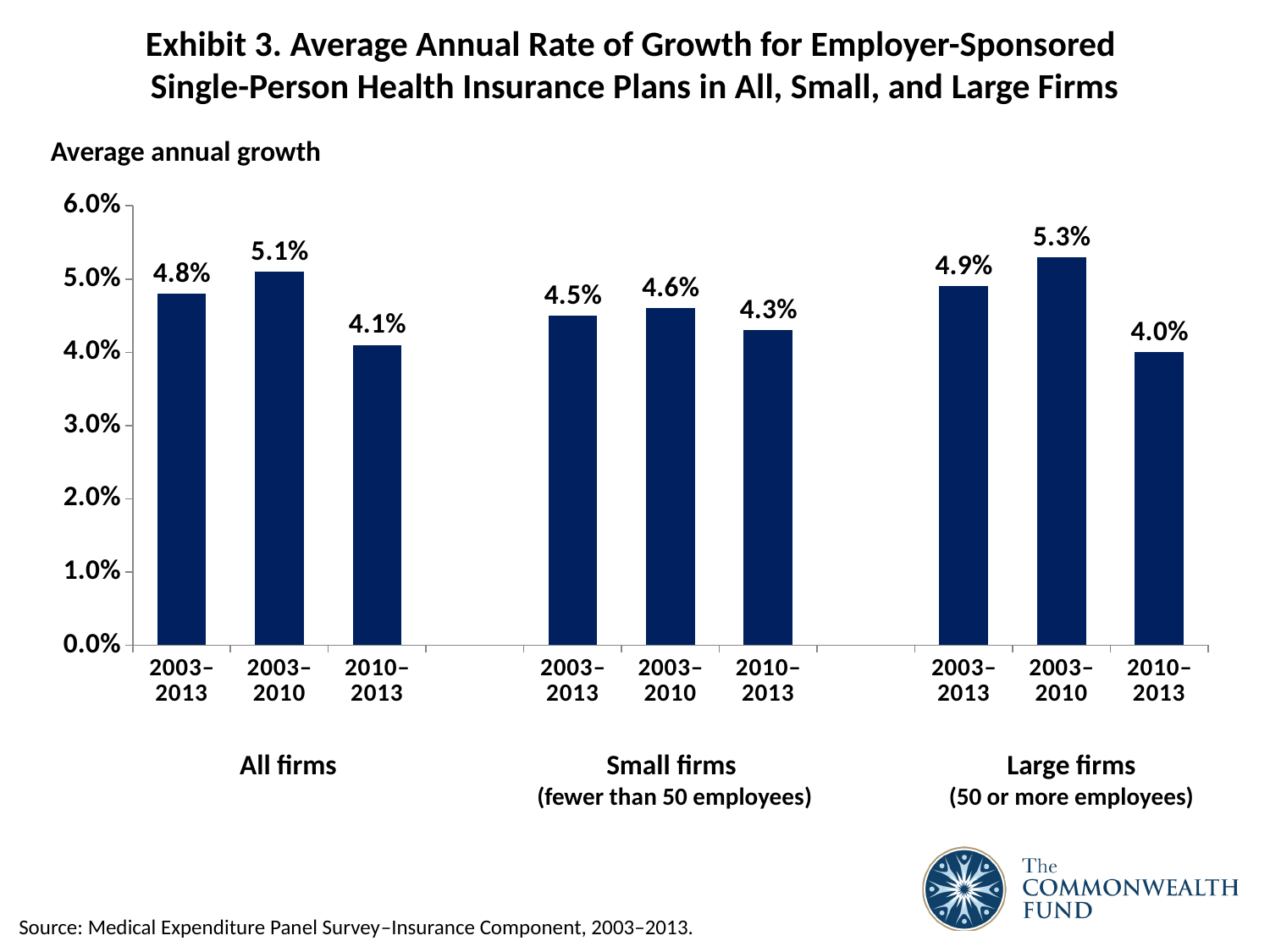
Which is larger: the 2003–2013 growth rate for small firms or for large firms? Large firms How many bars are plotted on the chart? 9 What is the label of the vertical axis? Average annual growth What is the difference between the 2003–2010 and 2010–2013 growth rates for large firms? 1.3% Is the 2010–2013 growth rate for all firms greater or less than 5.0%? less What is the average annual growth for small firms in 2010–2013? 4.3% What is the average annual growth for large firms in 2003–2010? 5.3% What is the difference between the 2003–2010 and 2010–2013 growth rates for all firms? 1.0% Which bar shows the lowest average annual growth on the chart? Large firms, 2010–2013 What is the average annual growth for all firms in 2003–2013? 4.8% What type of chart is shown on the slide? Bar chart Which bar shows the highest average annual growth on the chart? Large firms, 2003–2010